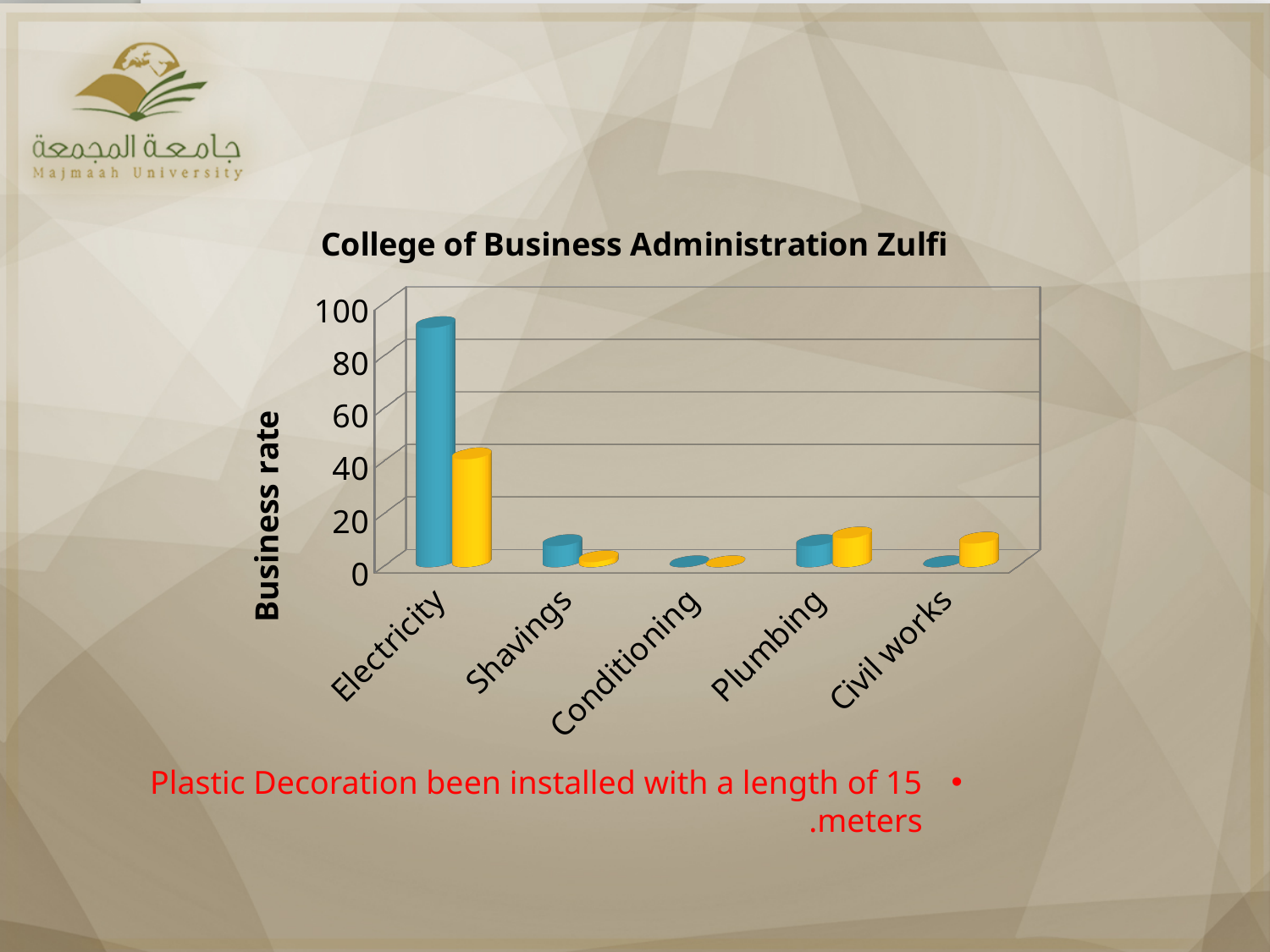
How many categories are shown on the x axis of the chart? 5 Is the value of the blue bar for Shavings greater or less than 20? less For Electricity, which bar is larger, the blue one or the yellow one? the blue one What kind of chart is shown on the slide? bar chart What is the title of the chart? College of Business Administration Zulfi Is the value of the yellow bar for Plumbing greater or less than 20? less Is the value of the blue bar for Electricity greater or less than 80? greater Which category has the tallest blue bar? Electricity Which category has the tallest yellow bar? Electricity For Civil works, which bar is larger, the blue one or the yellow one? the yellow one What is the label on the vertical axis of the chart? Business rate